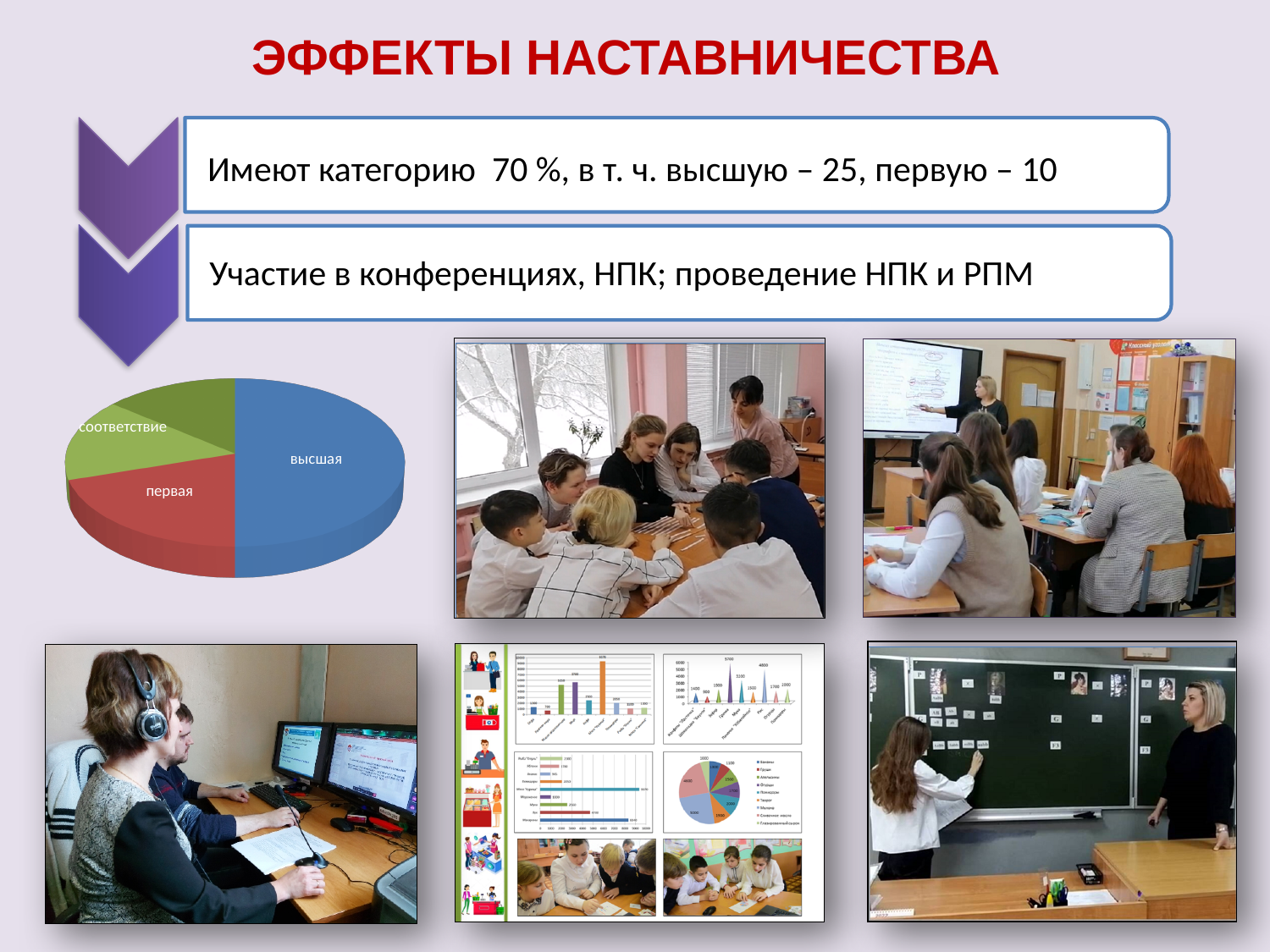
How many slices does the pie chart have? 4 In the pie chart, which slice is larger: высшая or первая? высшая What colour is the высшая slice in the pie chart? blue What colour is the первая slice in the pie chart? red In the pie chart, which slice is larger: высшая or соответствие? высшая What kind of chart is shown on the left of the slide? pie chart Which category has the largest slice in the pie chart? высшая